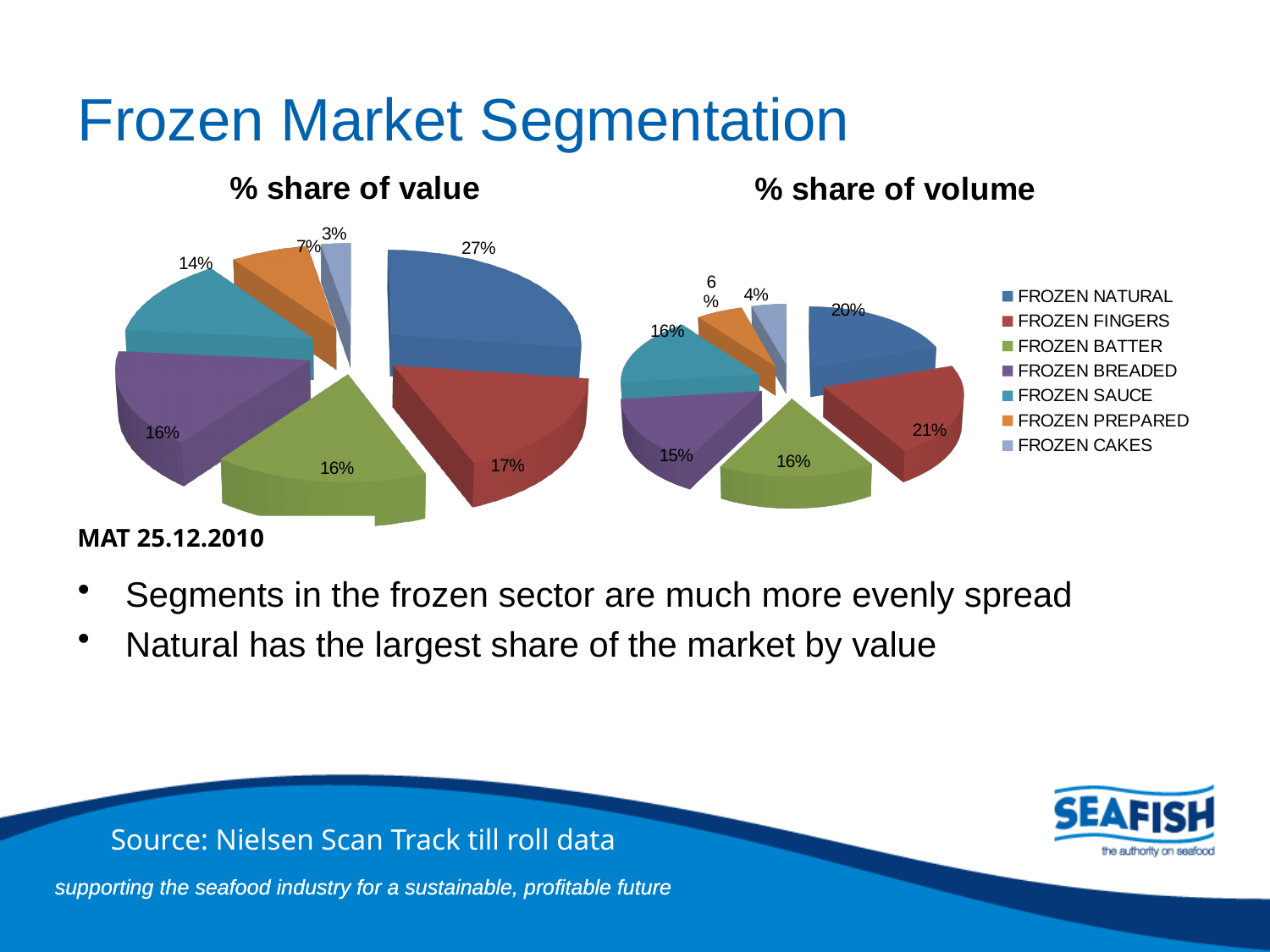
In the '% share of volume' chart, what is the share for FROZEN FINGERS? 21% In the '% share of value' chart, what is the share for FROZEN SAUCE? 14% Which colour represents FROZEN BATTER in the legend? Green In the '% share of volume' chart, which segment has the smallest share? FROZEN CAKES In the '% share of value' chart, what is the share for FROZEN NATURAL? 27% In the '% share of value' chart, what is the difference between the FROZEN NATURAL share and the FROZEN FINGERS share? 10% In the '% share of volume' chart, which is larger, the share for FROZEN NATURAL or the share for FROZEN FINGERS? FROZEN FINGERS How many segments does the legend list? 7 What kind of chart is the '% share of value' chart? Pie chart In the '% share of value' chart, which segment has the largest share? FROZEN NATURAL In the '% share of volume' chart, what is the share for FROZEN CAKES? 4% In the '% share of value' chart, what is the difference between the FROZEN PREPARED share and the FROZEN CAKES share? 4%